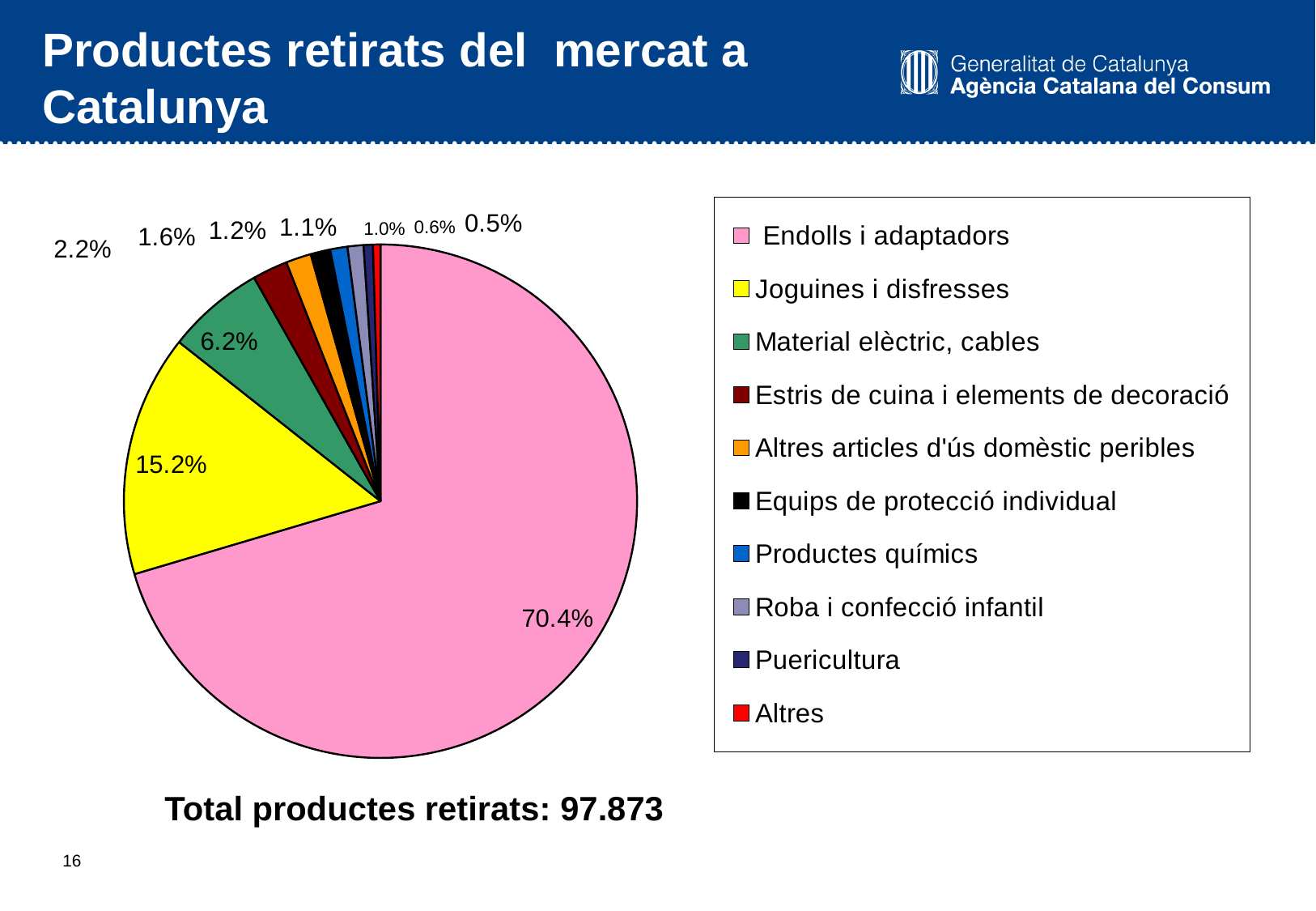
What share of the pie does Endolls i adaptadors represent? 70.4% How many categories does the legend list? 10 What total number of withdrawn products is stated below the chart? 97.873 What is the difference between the shares of Endolls i adaptadors and Joguines i disfresses? 55.2% Which category has the smallest slice of the pie? Altres Which is larger, the share for Material elèctric, cables or the share for Estris de cuina i elements de decoració? Material elèctric, cables What kind of chart is shown on the slide? pie chart What share of the pie does Joguines i disfresses represent? 15.2% Which category has the largest slice of the pie? Endolls i adaptadors What is the value shown for Material elèctric, cables? 6.2% What is the value shown for Altres articles d'ús domèstic peribles? 1.6% What is the value shown for Estris de cuina i elements de decoració? 2.2%